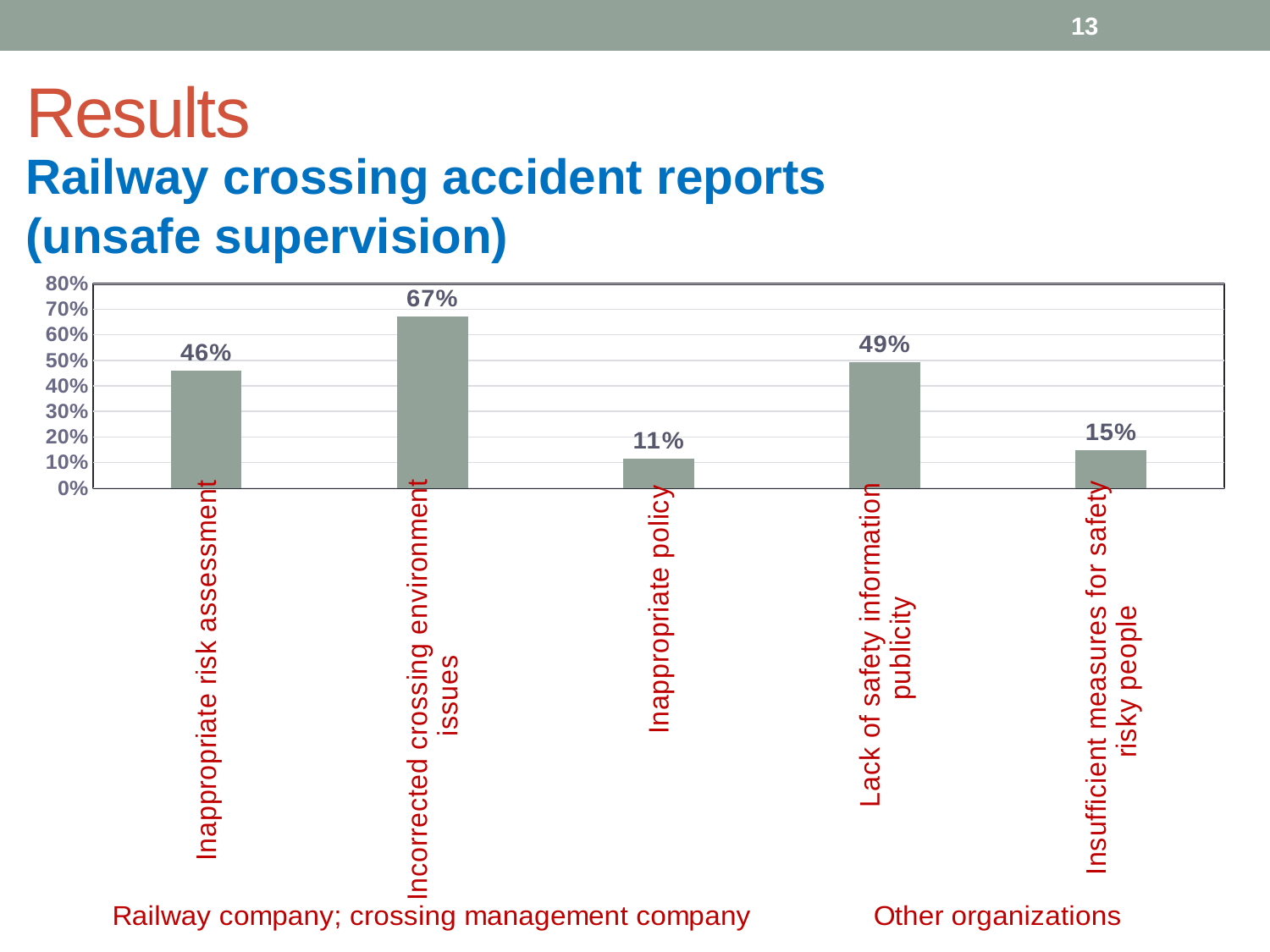
Which is larger, the value for Lack of safety information publicity or the value for Inappropriate risk assessment? Lack of safety information publicity What is the value for Lack of safety information publicity? 49% What kind of chart is shown on the slide? Bar chart Which category has the lowest value? Inappropriate policy Which group label is shown under the last two categories? Other organizations What is the value for Inappropriate policy? 11% What is the difference between the values for Incorrected crossing environment issues and Inappropriate risk assessment? 21% What is the value for Inappropriate risk assessment? 46% Which category has the highest value? Incorrected crossing environment issues What is the value for Incorrected crossing environment issues? 67% How many categories are shown in the chart? 5 What is the value for Insufficient measures for safety risky people? 15%